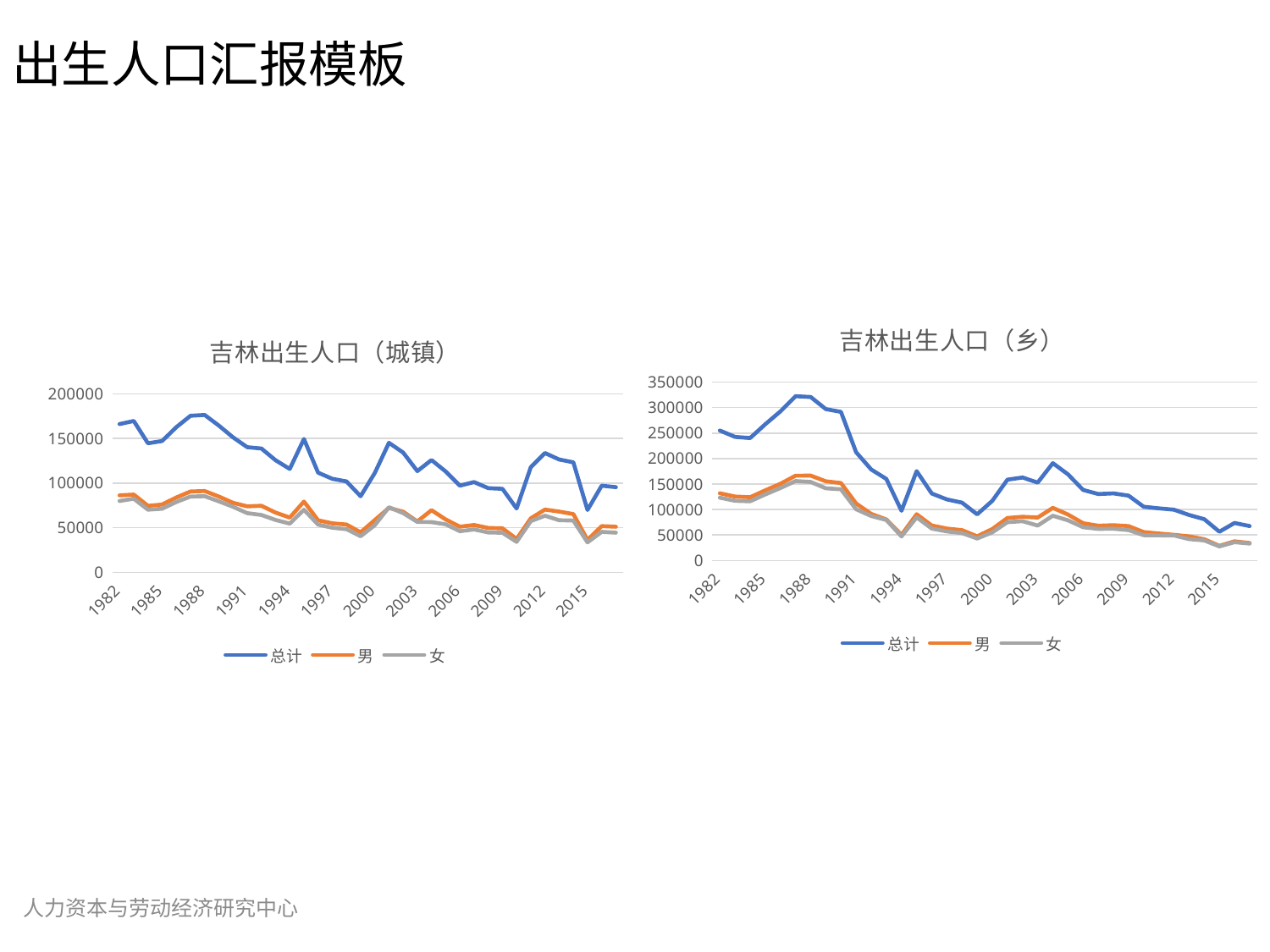
In the 吉林出生人口（乡） chart, is the value of 总计 in 2015 greater or less than 100000? less In the 吉林出生人口（乡） chart, is the value of 总计 in 1988 greater or less than 300000? greater In the 吉林出生人口（城镇） chart, which series has the highest values throughout? 总计 In the 吉林出生人口（乡） chart, does the 总计 series overall rise or fall from 1988 to 2015? fall In the 吉林出生人口（乡） chart, is the value of 总计 in 1994 greater or less than 150000? less How many series does the legend of the 吉林出生人口（乡） chart list? 3 What is the title of the chart on the right side of the slide? 吉林出生人口（乡） In the 吉林出生人口（乡） chart, which series is higher in 1988: 男 or 女? 男 In the 吉林出生人口（城镇） chart, which is larger: 总计 in 1982 or 总计 in 2015? 1982 What kind of chart is the 吉林出生人口（城镇） chart? line chart